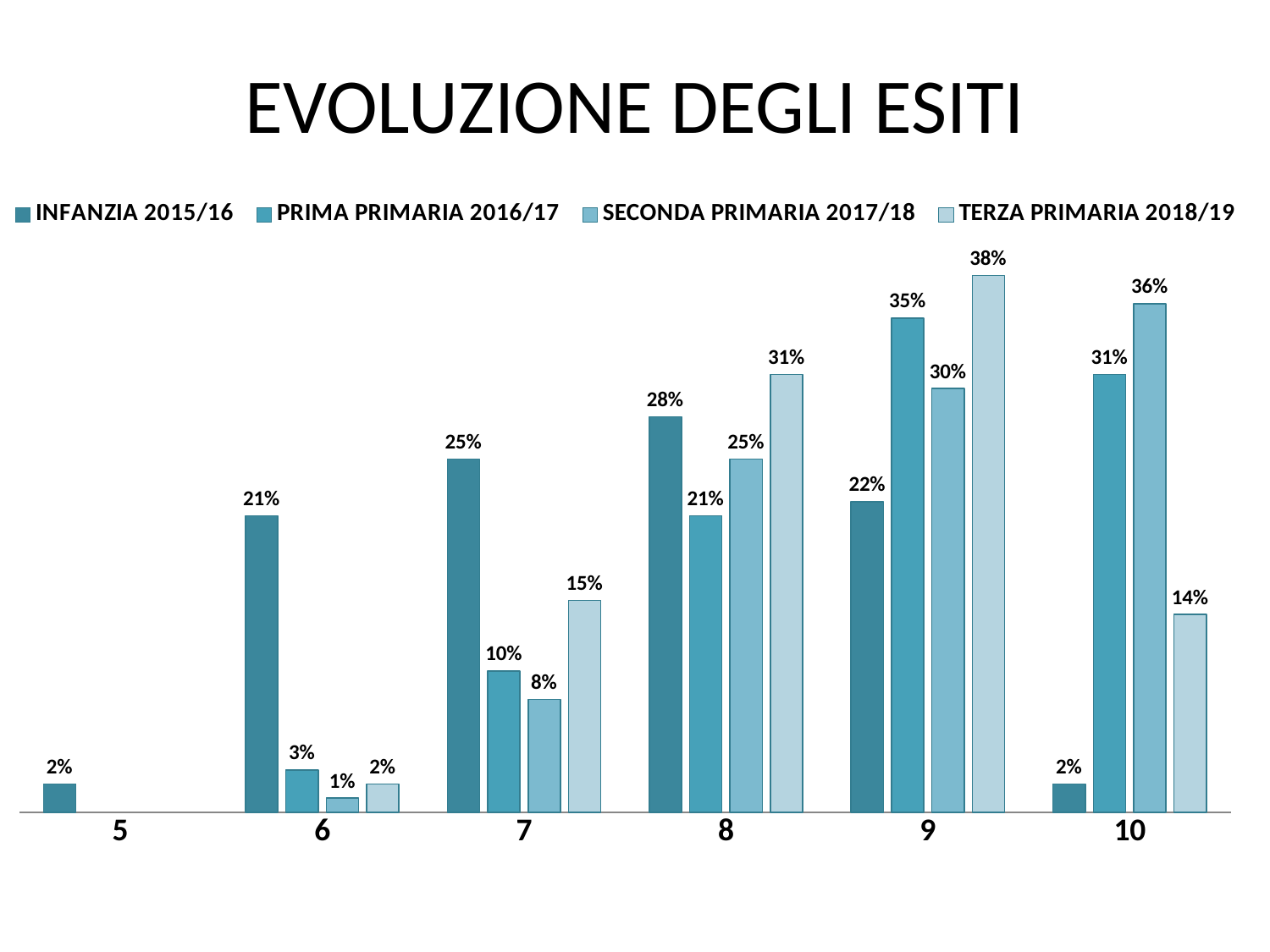
What is the value for PRIMA PRIMARIA 2016/17 at category 6? 3% How many series does the legend list? 4 What is the value for SECONDA PRIMARIA 2017/18 at category 10? 36% Which is larger at category 8: PRIMA PRIMARIA 2016/17 or SECONDA PRIMARIA 2017/18? SECONDA PRIMARIA 2017/18 Which category has the lowest value for TERZA PRIMARIA 2018/19 among those with a bar? 6 What is the value for TERZA PRIMARIA 2018/19 at category 9? 38% What is the value for INFANZIA 2015/16 at category 7? 25% What is the difference between TERZA PRIMARIA 2018/19 and INFANZIA 2015/16 at category 9? 16% How many categories are shown on the x axis? 6 What is the title of the chart? EVOLUZIONE DEGLI ESITI What type of chart is shown on the slide? bar chart Which category has the highest value for INFANZIA 2015/16? 8